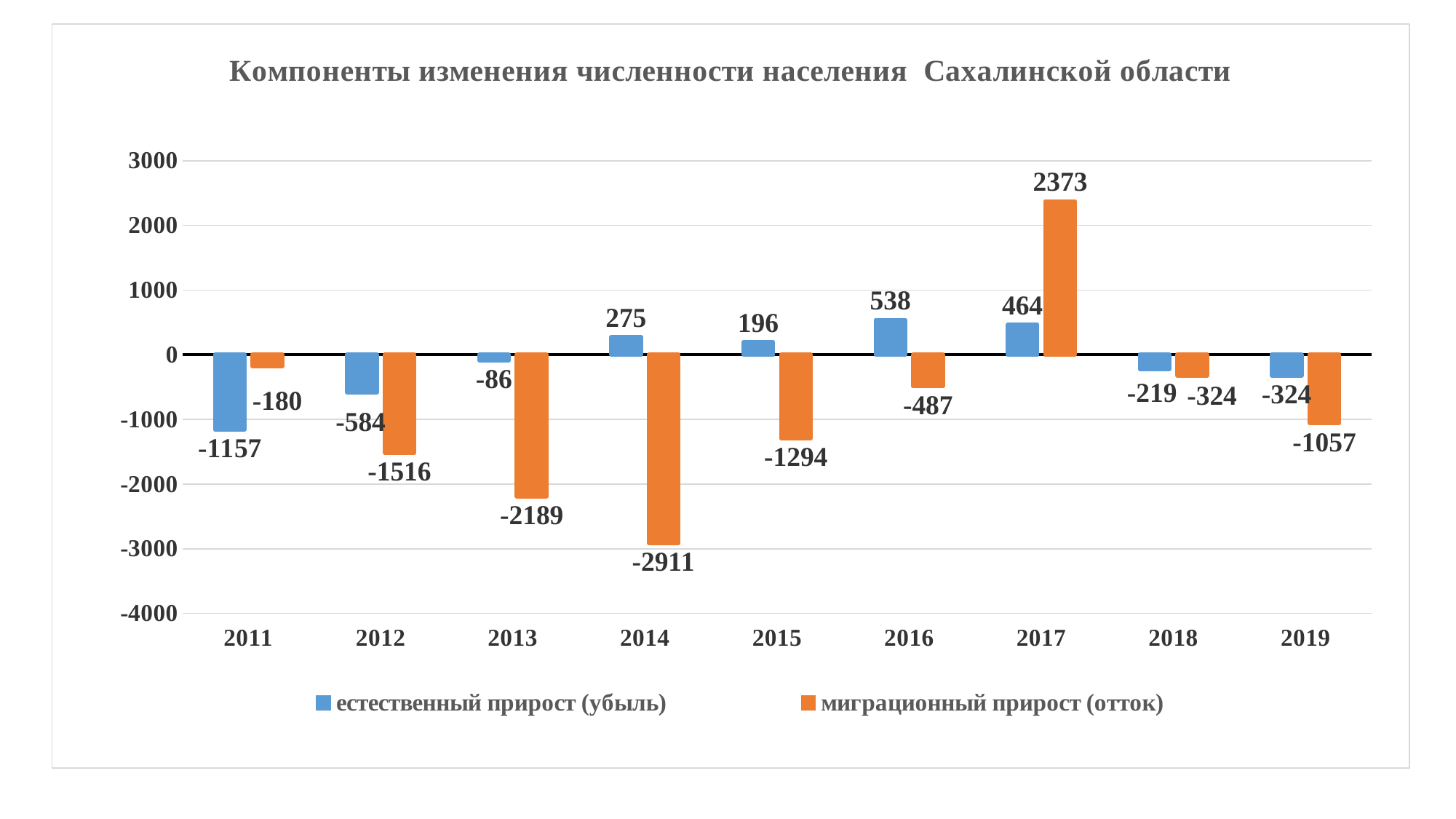
In which year is миграционный прирост (отток) the lowest? 2014 What is the value of естественный прирост (убыль) for 2016? 538 What is the difference between миграционный прирост (отток) in 2017 and естественный прирост (убыль) in 2017? 1909 What is the value of миграционный прирост (отток) for 2014? -2911 What kind of chart is shown on the slide? bar chart Which is larger in 2012: естественный прирост (убыль) or миграционный прирост (отток)? естественный прирост (убыль) What is the title of the chart? Компоненты изменения численности населения Сахалинской области What is the value of естественный прирост (убыль) for 2011? -1157 How many series does the legend list? 2 In which year is естественный прирост (убыль) the highest? 2016 How many years are shown on the x axis? 9 What is the value of миграционный прирост (отток) for 2017? 2373